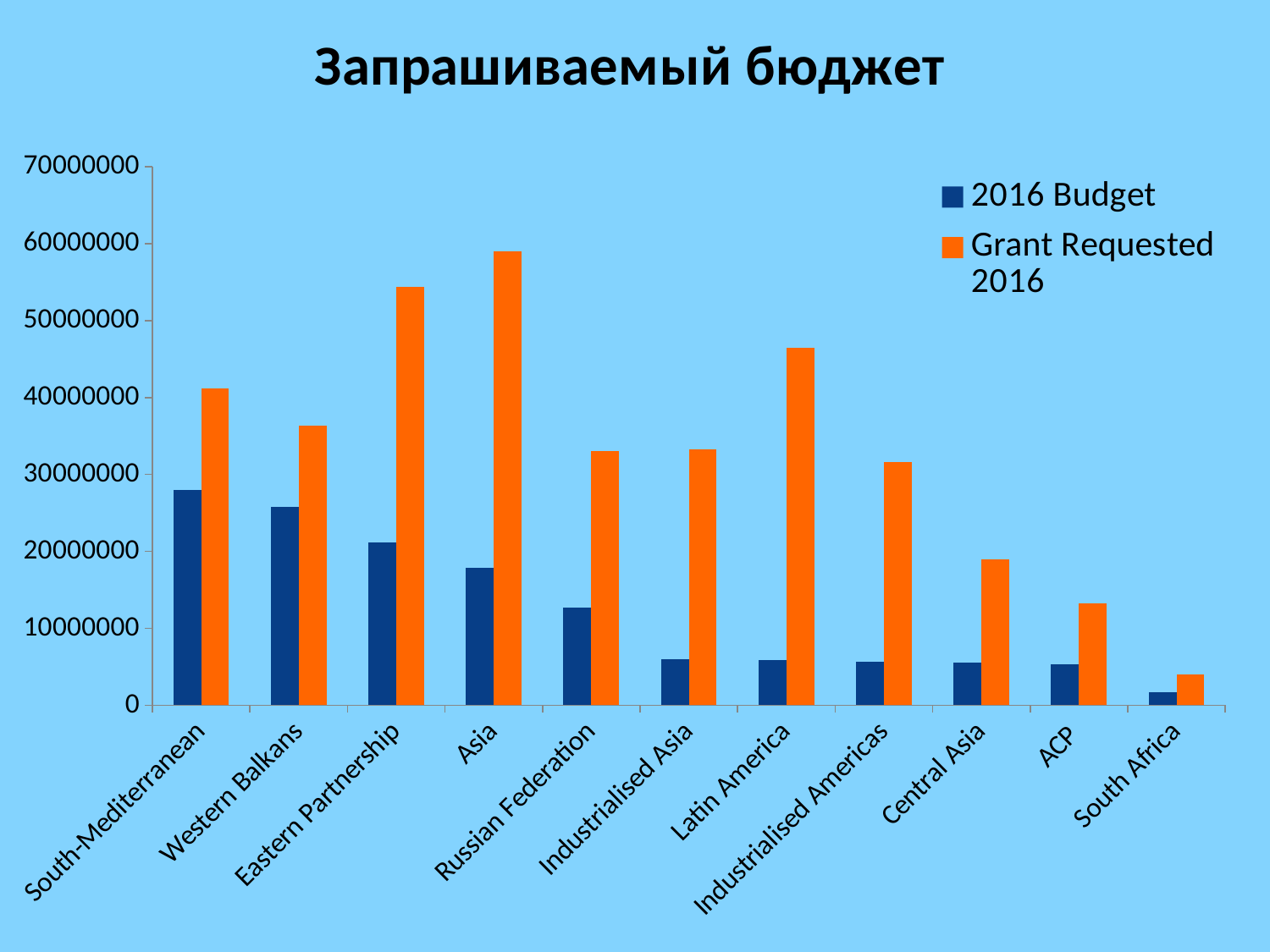
How many series does the legend list? 2 What kind of chart is shown on the slide? bar chart Which category has the lowest Grant Requested 2016 value? South Africa Is the Grant Requested 2016 value for Central Asia greater or less than 20000000? less Is the Grant Requested 2016 value for Eastern Partnership greater or less than 50000000? greater What is the title of the chart? Запрашиваемый бюджет Is the 2016 Budget value for Russian Federation greater or less than 10000000? greater Do the 2016 Budget values generally rise or fall from left to right along the x axis? fall Which is larger: the Grant Requested 2016 value for Latin America or for Industrialised Americas? Latin America Which category has the highest Grant Requested 2016 value? Asia How many categories are shown on the x axis? 11 Which category has the highest 2016 Budget value? South-Mediterranean